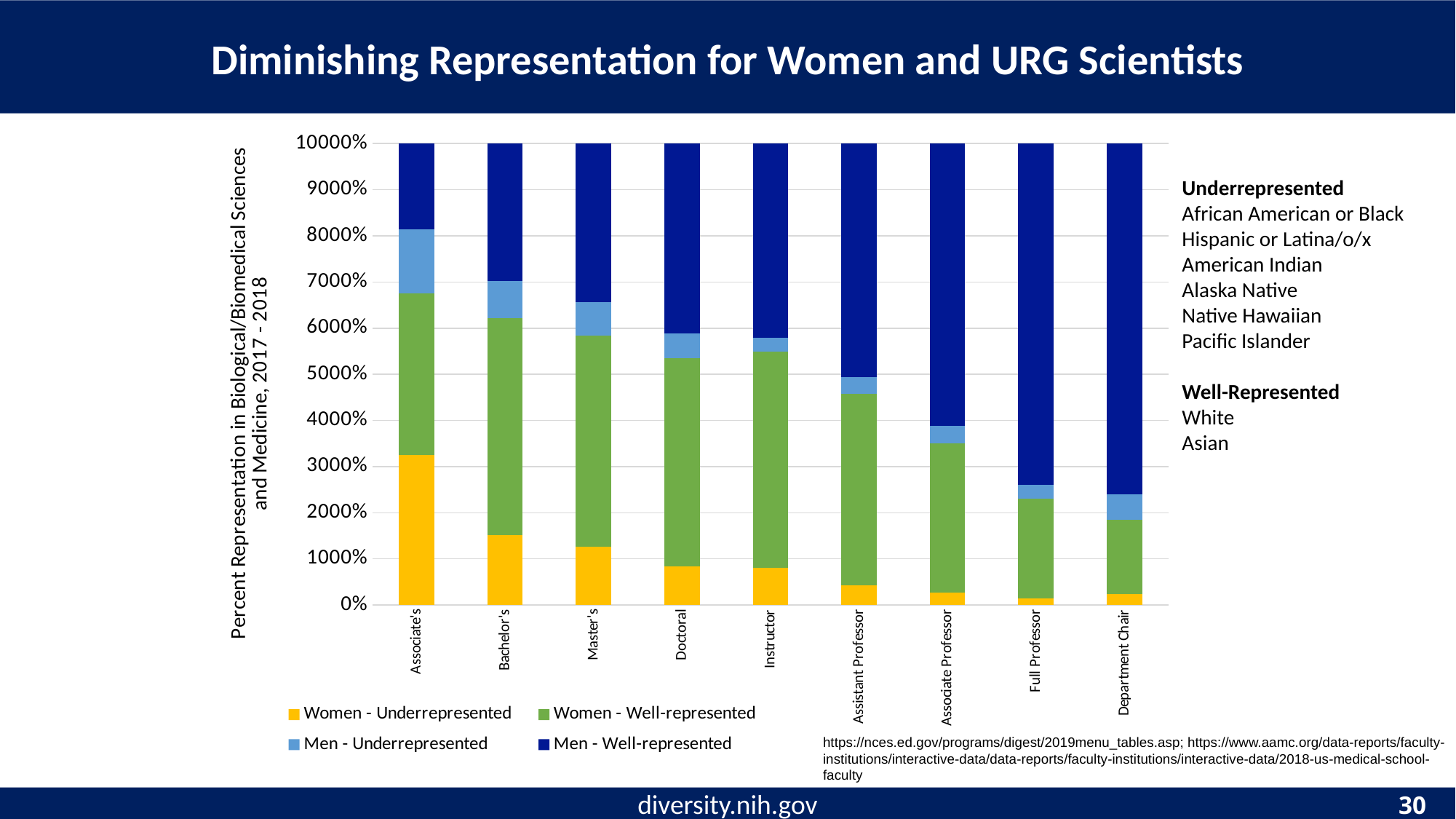
Which category has the highest value for Women - Underrepresented? Associate's Which is larger, the Men - Well-represented value for Department Chair or for Associate's? Department Chair What is the title of the chart's y axis? Percent Representation in Biological/Biomedical Sciences and Medicine, 2017 - 2018 Is the Women - Underrepresented value for Bachelor's greater or less than 1000%? greater How many series does the chart's legend list? 4 Is the Women - Underrepresented value for Doctoral greater or less than 1000%? less Is the Women - Underrepresented value for Associate's greater or less than 3000%? greater What kind of chart is shown on the slide? Stacked bar chart How many categories are shown along the x axis of the chart? 9 Does the Women - Underrepresented series generally rise or fall from Associate's to Department Chair? Fall Which is larger, the Women - Underrepresented value for Associate's or for Bachelor's? Associate's